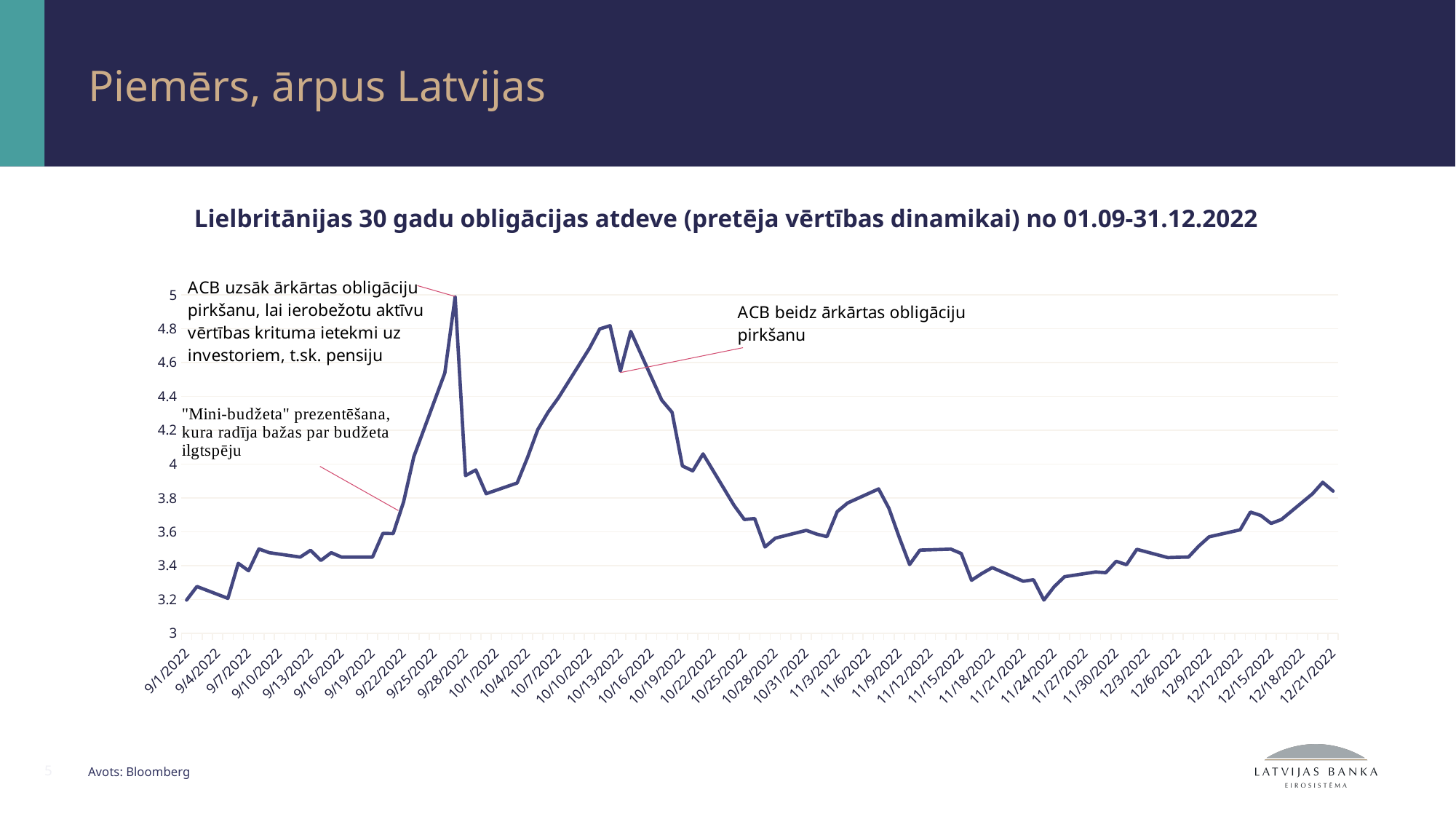
What is the source cited for the chart? Bloomberg What is the title of the chart? Lielbritānijas 30 gadu obligācijas atdeve (pretēja vērtības dinamikai) no 01.09-31.12.2022 Which is higher, the value on 9/1/2022 or the value on 12/21/2022? 12/21/2022 How many lines are plotted on the chart? 1 Is the value on 9/1/2022 greater or less than 3.4? less Which is higher, the value on 9/28/2022 or the value on 10/10/2022? 10/10/2022 Is the value on 12/21/2022 greater or less than 3.6? greater What kind of chart is shown on the slide? line chart Is the value on 11/24/2022 greater or less than 3.4? less